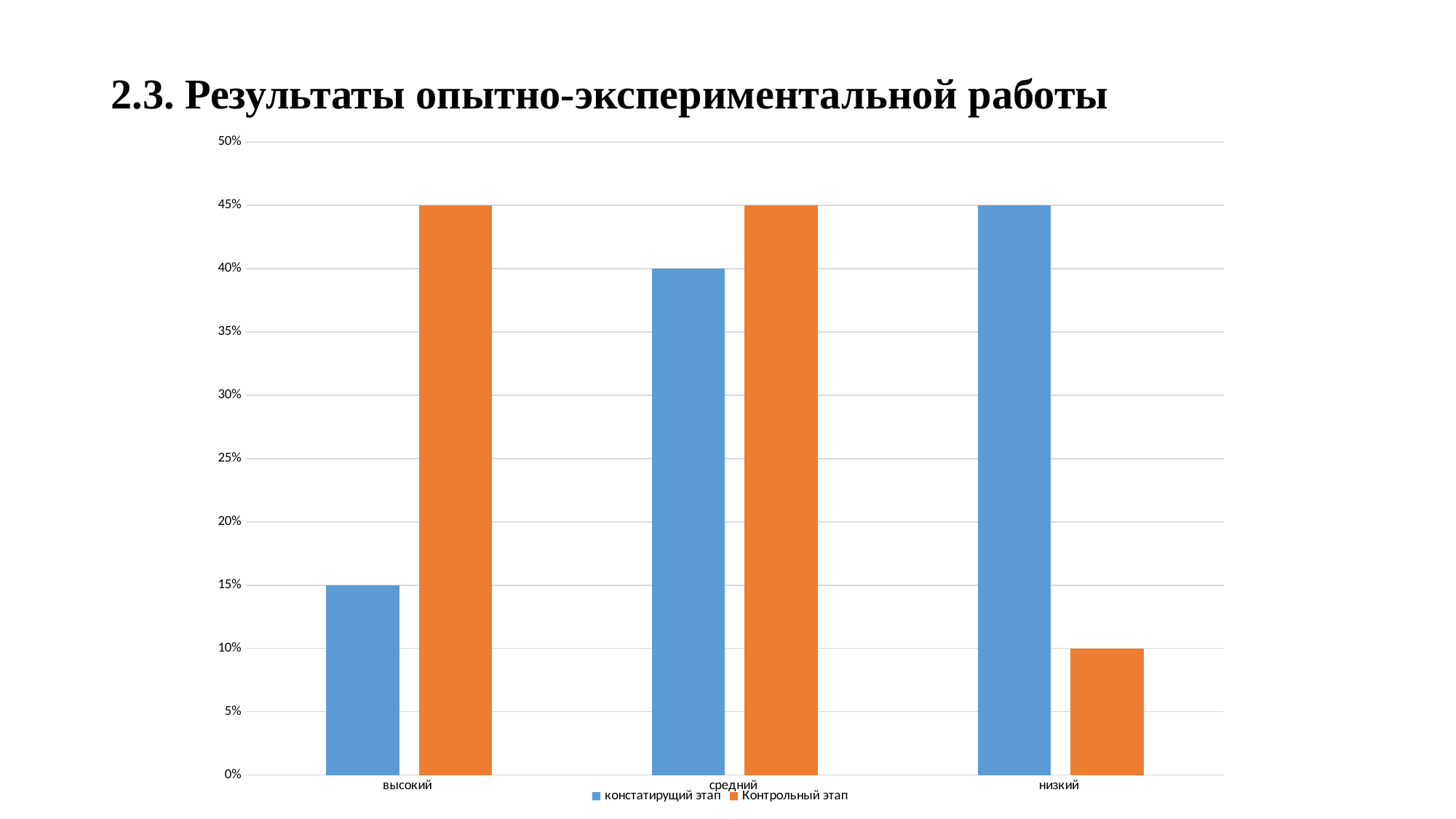
What is the value for 'высокий' in the 'констатирущий этап' series? 15% For 'низкий', which series has the larger value: 'констатирущий этап' or 'Контрольный этап'? констатирущий этап What is the value for 'высокий' in the 'Контрольный этап' series? 45% Which category has the lowest value in the 'констатирущий этап' series? высокий What is the value for 'средний' in the 'констатирущий этап' series? 40% What type of chart is shown on the slide? bar chart How many series does the chart's legend list? 2 Which series is shown in orange in the chart? Контрольный этап How many categories are shown on the x axis of the chart? 3 Which category has the lowest value in the 'Контрольный этап' series? низкий What is the value for 'низкий' in the 'Контрольный этап' series? 10% What is the difference between the 'Контрольный этап' and 'констатирущий этап' values for 'высокий'? 30%